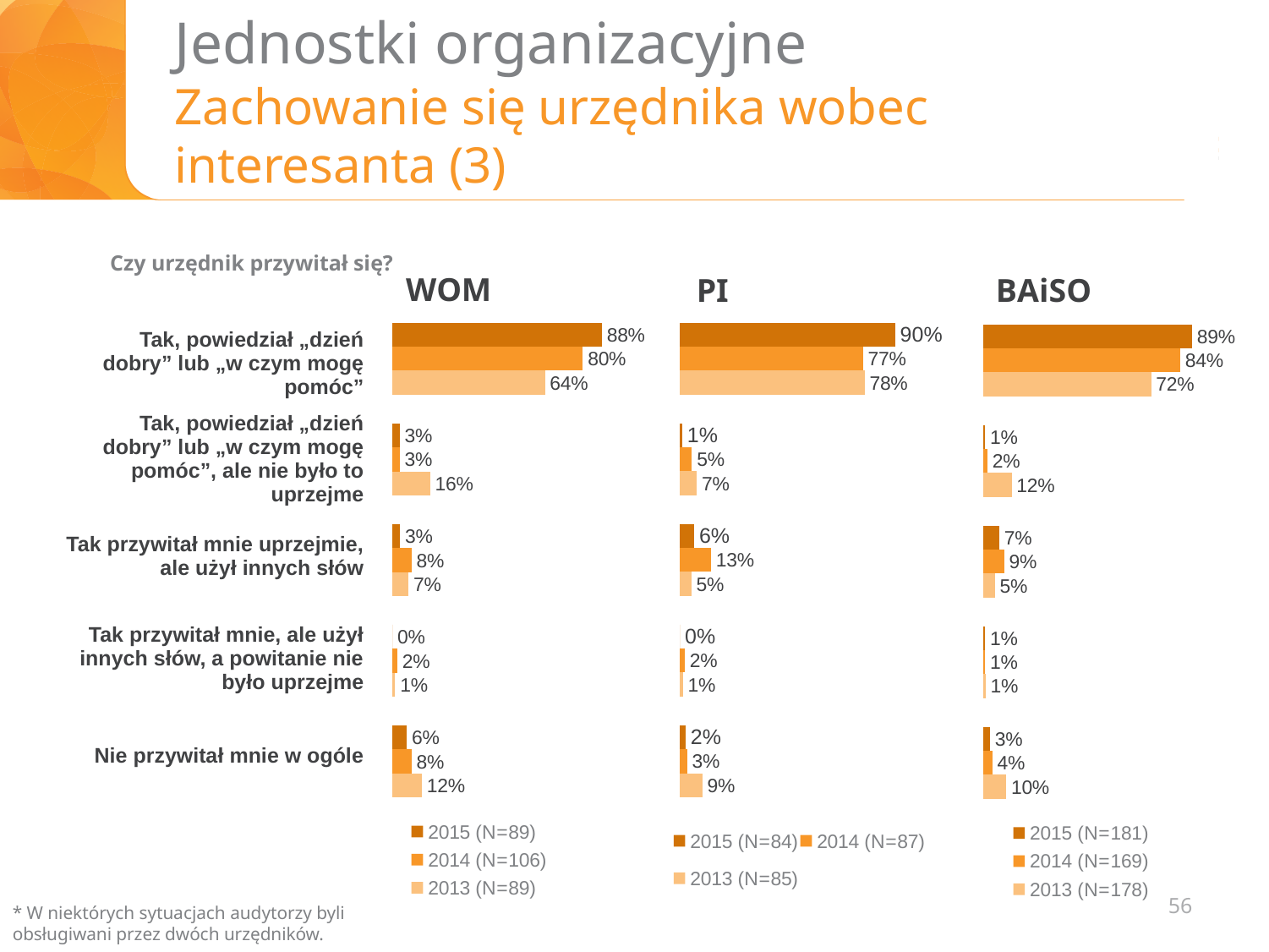
In the PI chart, what is the 2014 value for "Tak przywitał mnie uprzejmie, ale użył innych słów"? 13% In the PI chart, what is the 2015 value for "Tak przywitał mnie, ale użył innych słów, a powitanie nie było uprzejme"? 0% What kind of chart is the BAiSO chart? bar chart In the WOM chart, what is the 2015 value for "Tak, powiedział „dzień dobry” lub „w czym mogę pomóc”"? 88% How many series does the legend of the PI chart list? 3 What sample size (N) does the legend of the BAiSO chart give for 2015? N=181 In the PI chart, what is the difference between the 2015 and 2013 values for "Tak, powiedział „dzień dobry” lub „w czym mogę pomóc”"? 12% In the WOM chart, what is the difference between the 2013 and 2015 values for "Nie przywitał mnie w ogóle"? 6% In the BAiSO chart, what is the 2013 value for "Nie przywitał mnie w ogóle"? 10% In the WOM chart, which category has the highest 2013 value? Tak, powiedział „dzień dobry” lub „w czym mogę pomóc” How many categories are shown in the WOM chart? 5 In the BAiSO chart, which is larger for "Tak, powiedział „dzień dobry” lub „w czym mogę pomóc”, ale nie było to uprzejme": the 2013 value or the 2014 value? 2013